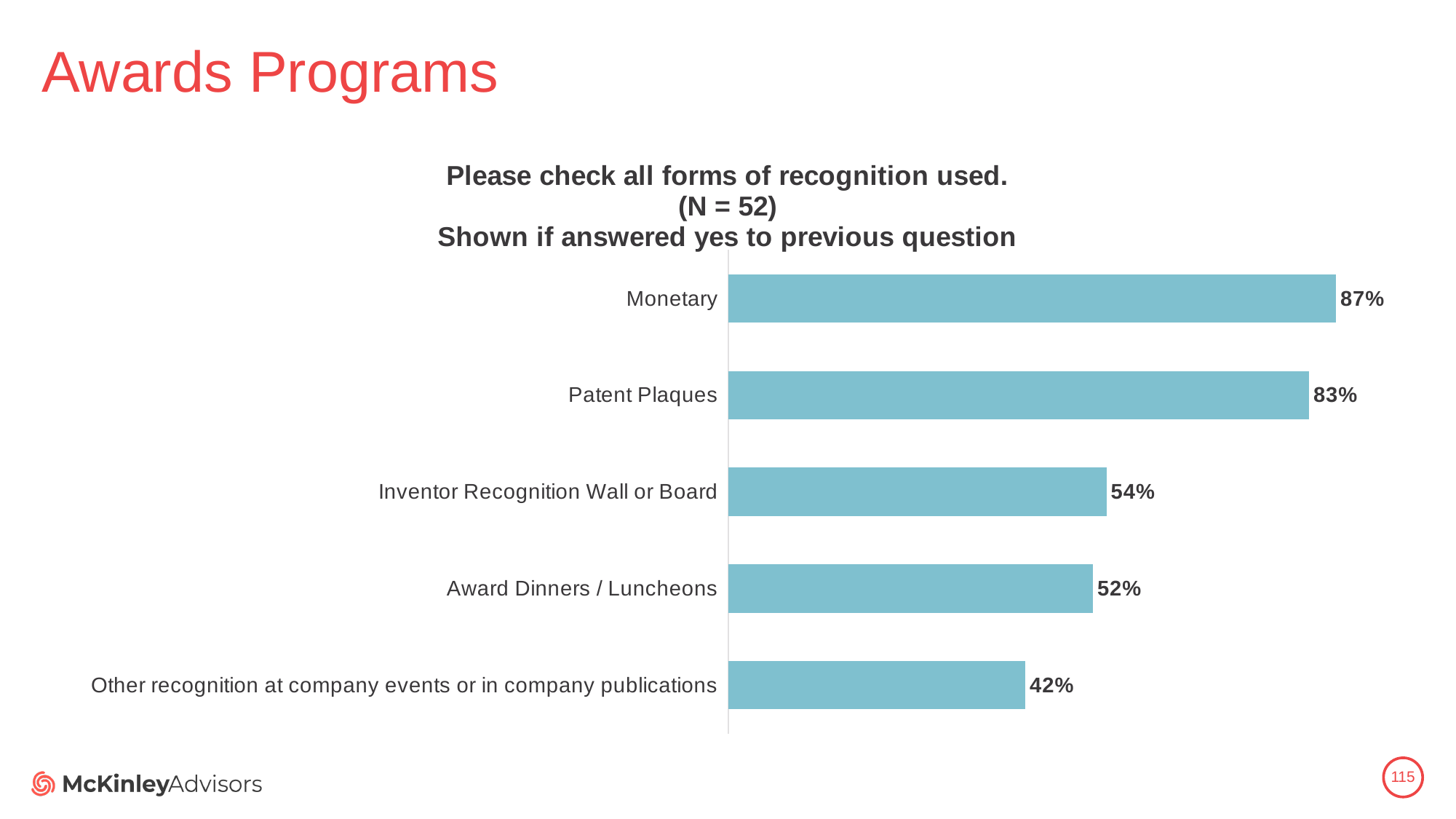
What percentage of respondents use Monetary recognition? 87% Which form of recognition has the highest percentage? Monetary What is the value for Patent Plaques? 83% What is the difference in percentage points between Award Dinners / Luncheons and Other recognition at company events or in company publications? 10 What type of chart is shown on the slide? Bar chart What is the sample size (N) stated in the chart title? 52 What percentage is shown for Inventor Recognition Wall or Board? 54% How many forms of recognition are shown in the chart? 5 What is the difference in percentage points between Monetary and Patent Plaques? 4 Which form of recognition has the lowest percentage? Other recognition at company events or in company publications Which is larger, the value for Inventor Recognition Wall or Board or the value for Award Dinners / Luncheons? Inventor Recognition Wall or Board What is the value for Other recognition at company events or in company publications? 42%